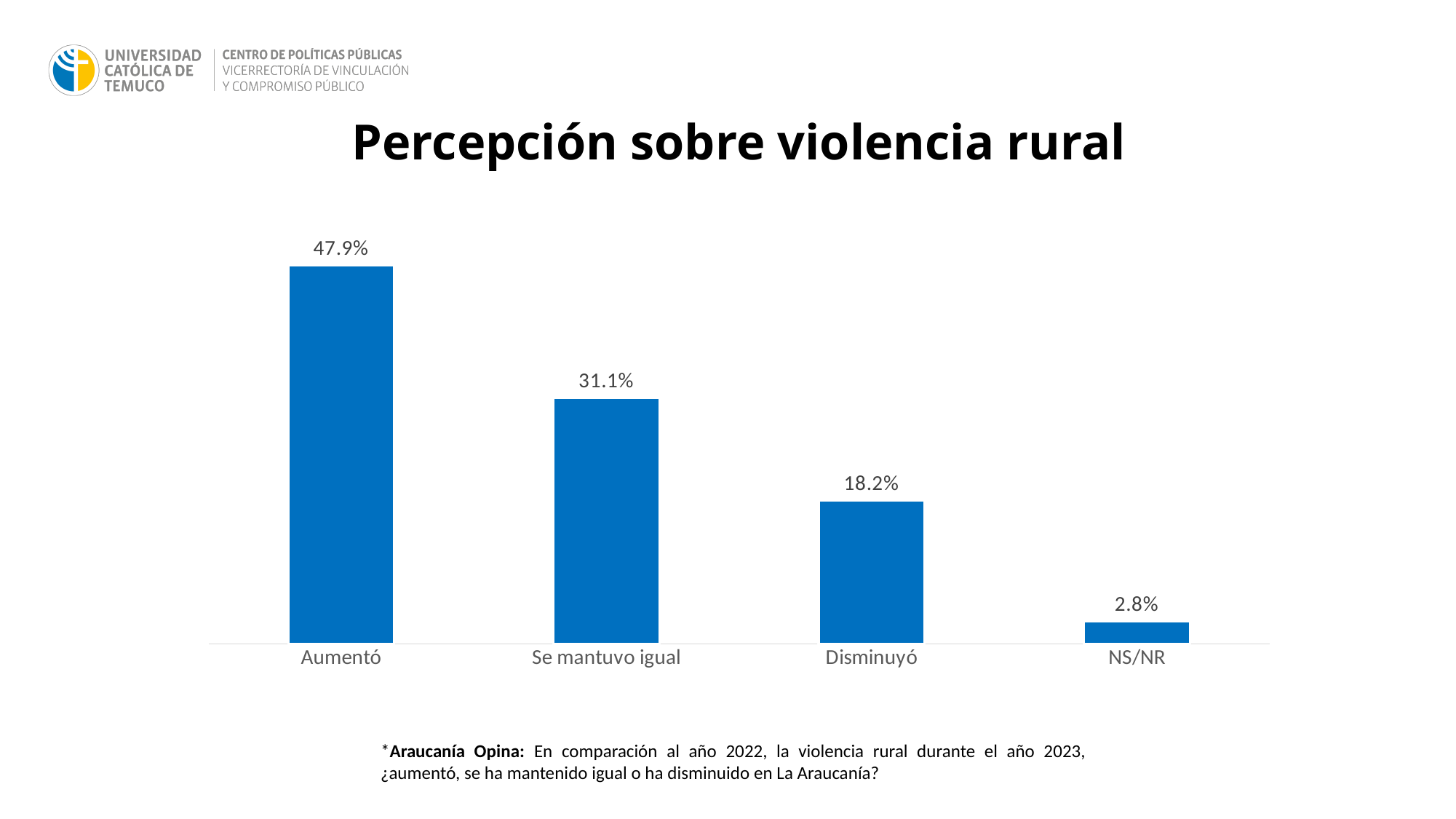
What is the value for Aumentó? 47.9% Which is larger, the value for Disminuyó or the value for NS/NR? Disminuyó What is the value for NS/NR? 2.8% Which category has the highest value? Aumentó What is the difference between the values for Se mantuvo igual and Disminuyó? 12.9% Which category has the lowest value? NS/NR What kind of chart is shown on the slide? Bar chart What is the value for Disminuyó? 18.2% What is the title of the chart? Percepción sobre violencia rural How many categories are shown on the x axis? 4 What is the value for Se mantuvo igual? 31.1% What is the difference between the values for Aumentó and Se mantuvo igual? 16.8%